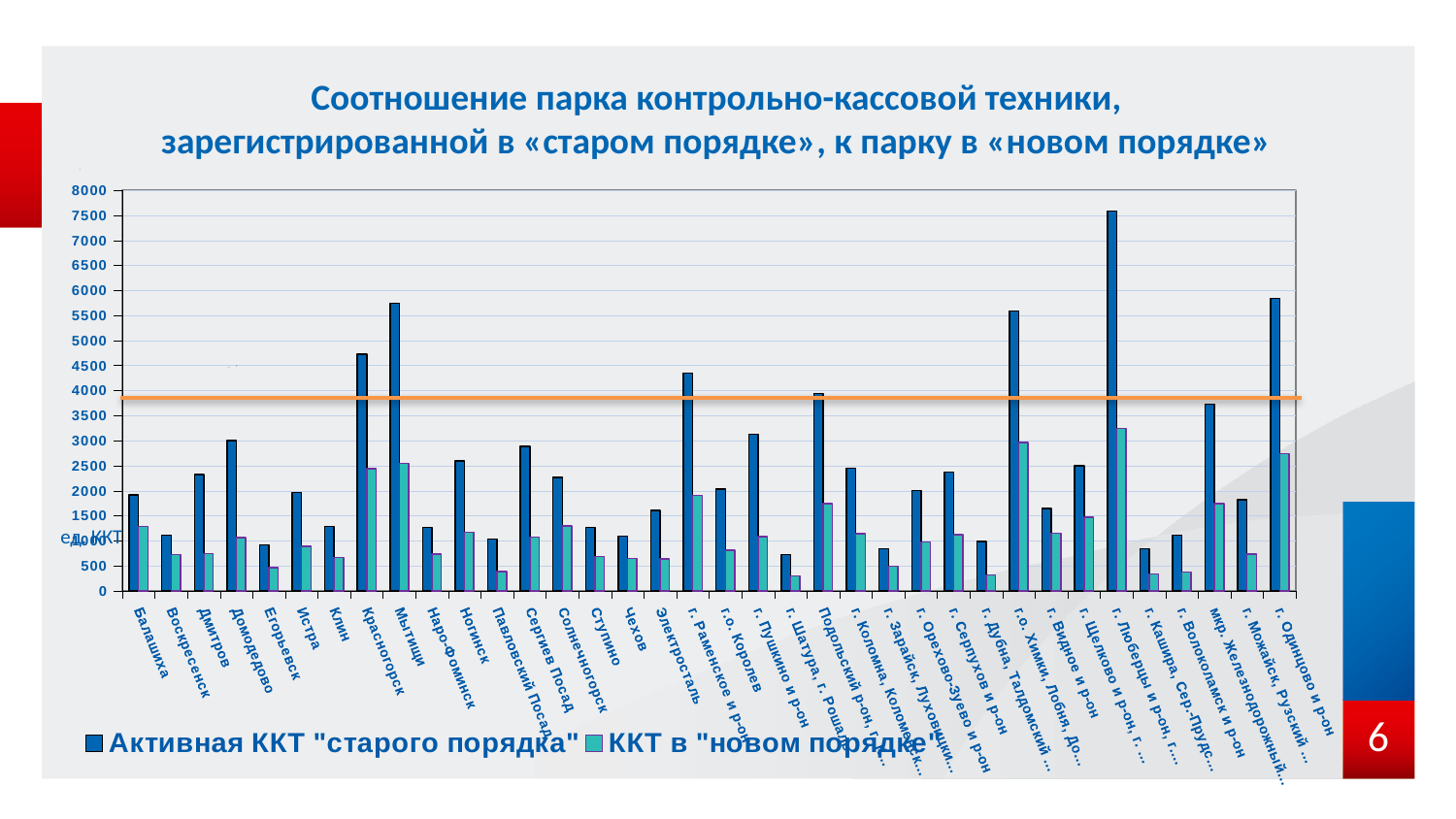
Which is larger for Активная ККТ "старого порядка": г. Люберцы и р-он or г. Одинцово и р-он? г. Люберцы и р-он Which is larger for Активная ККТ "старого порядка": Мытищи or Красногорск? Мытищи Is the value for Красногорск in the series Активная ККТ "старого порядка" greater or less than 4500? greater Is the value for Мытищи in the series Активная ККТ "старого порядка" greater or less than 5500? greater Is the value for г. Люберцы и р-он in the series Активная ККТ "старого порядка" greater or less than 7000? greater How many series does the legend list? 2 What kind of chart is shown on the slide? bar chart Which category has the highest value for Активная ККТ "старого порядка"? г. Люберцы и р-он What is the name of the second series in the legend? ККТ в "новом порядке" How many categories are shown on the x axis? 36